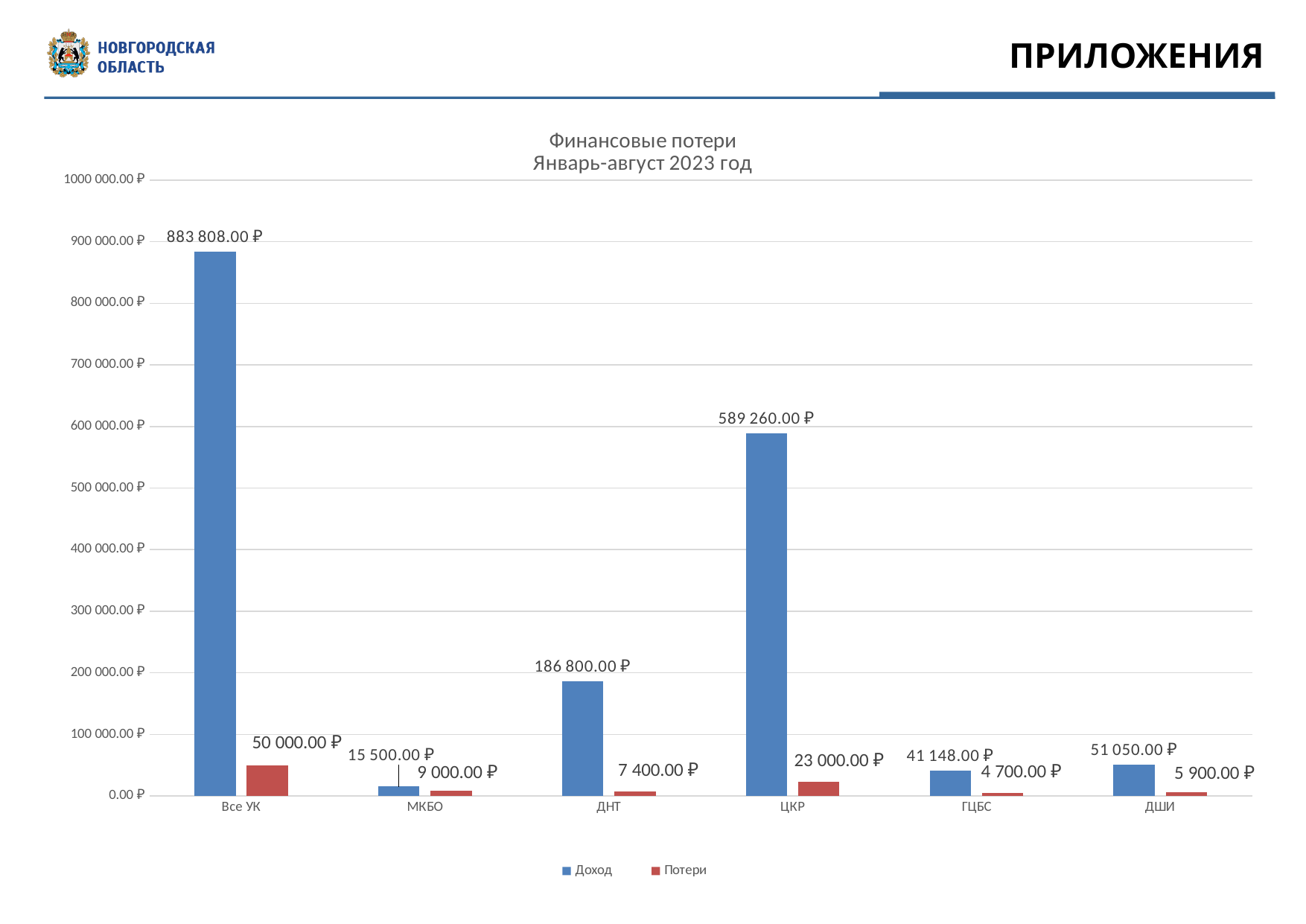
Is the Доход value for ЦКР greater or less than 500 000.00 ₽? greater What is the difference between the Доход and Потери values for ДНТ? 179 400.00 ₽ Which category has the highest Доход value? Все УК How many categories are shown on the x axis? 6 Which category has the lowest Потери value? ГЦБС What is the Доход value for ГЦБС? 41 148.00 ₽ What is the Потери value for МКБО? 9 000.00 ₽ How many series does the legend list? 2 What is the Доход value for ЦКР? 589 260.00 ₽ Which is larger, the Доход value for ДШИ or the Доход value for ГЦБС? ДШИ What kind of chart is shown on the slide? bar chart What is the title of the chart? Финансовые потери Январь-август 2023 год